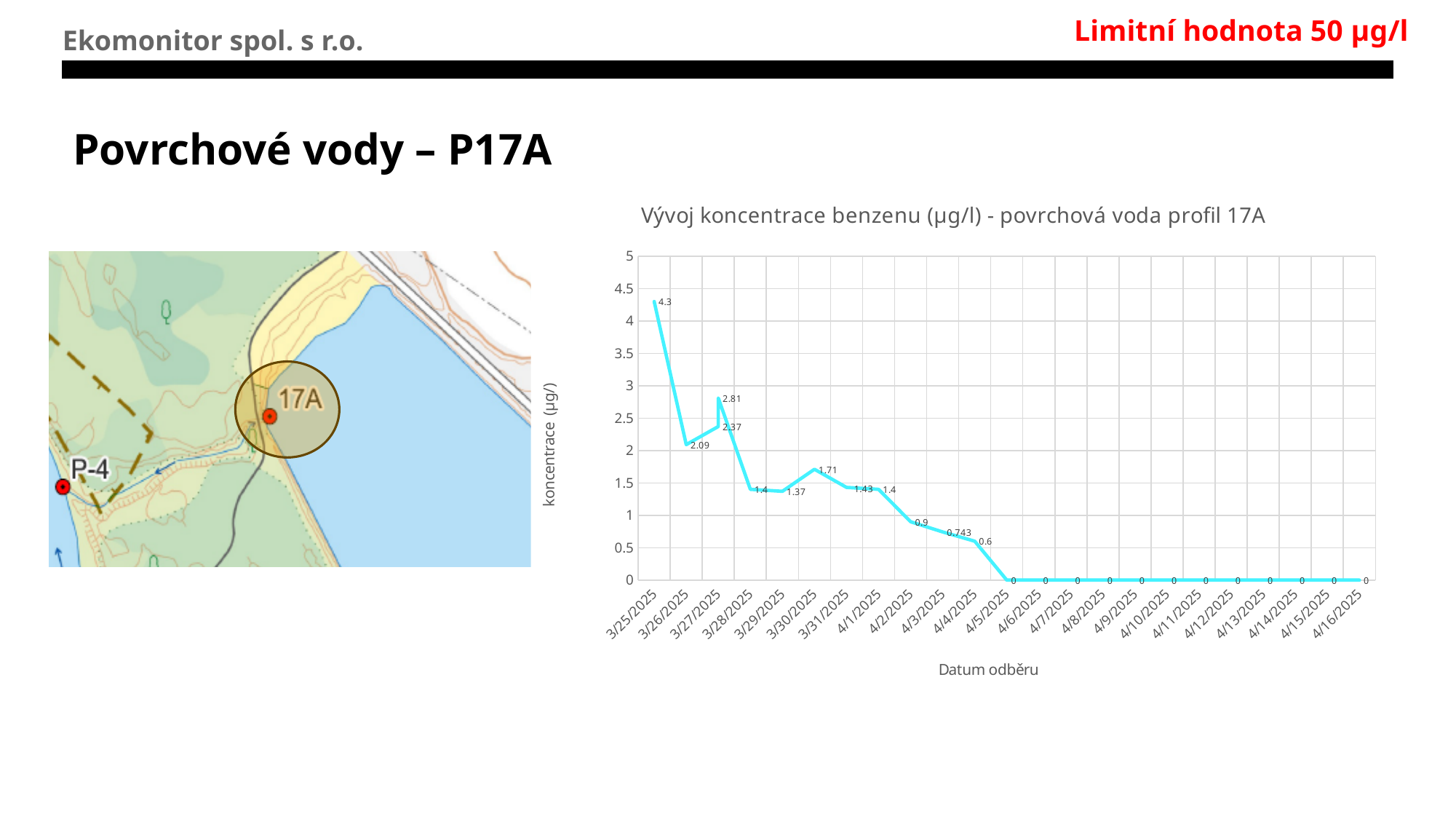
What is the benzene concentration on 4/3/2025? 0.743 What is the benzene concentration on 4/10/2025? 0 What is the benzene concentration on 4/4/2025? 0.6 What is the benzene concentration on 3/25/2025? 4.3 Is the value for 3/25/2025 greater or less than 4? greater What kind of chart is shown on the slide? line chart What is the benzene concentration on 3/30/2025? 1.71 What is the benzene concentration on 3/26/2025? 2.09 What is the difference between the concentration on 3/25/2025 and on 3/26/2025? 2.21 Do the concentration values generally rise or fall over the dates shown? fall On which date is the benzene concentration highest? 3/25/2025 Which date has the higher concentration, 3/30/2025 or 4/2/2025? 3/30/2025